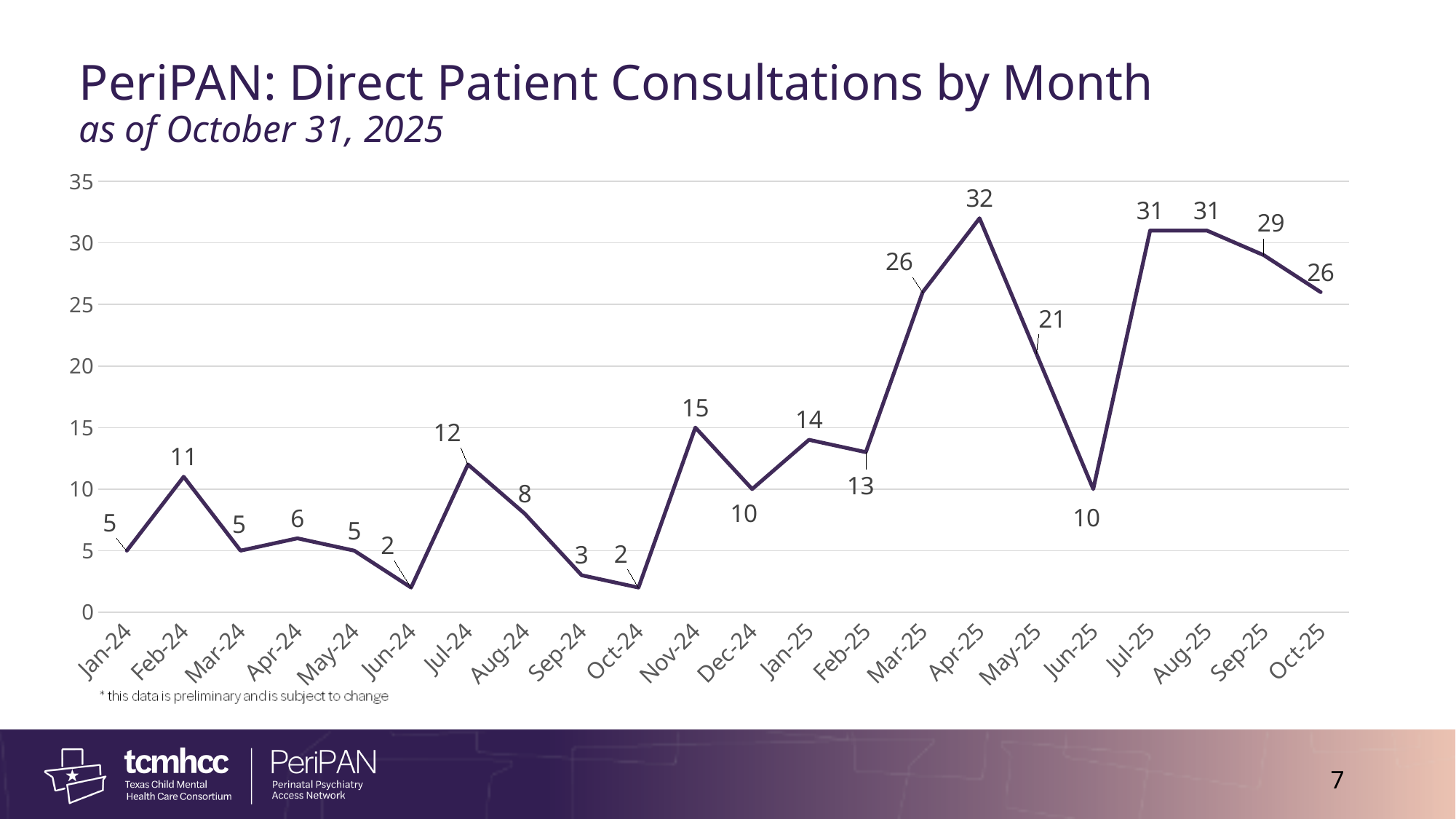
What is the difference between the values for Apr-25 and May-25? 11 Which month has the highest number of direct patient consultations? Apr-25 What is the value for Nov-24? 15 How many months are plotted on the x axis? 22 What is the title of the chart? PeriPAN: Direct Patient Consultations by Month What is the difference between the values for Jul-24 and Jun-24? 10 What is the value for Oct-25? 26 What type of chart is shown on the slide? line chart Which is larger, the value for Feb-24 or the value for Dec-24? Feb-24 Do the values generally rise or fall from Jul-25 to Oct-25? fall How many direct patient consultations were there in Apr-25? 32 What is the lowest value plotted on the chart? 2